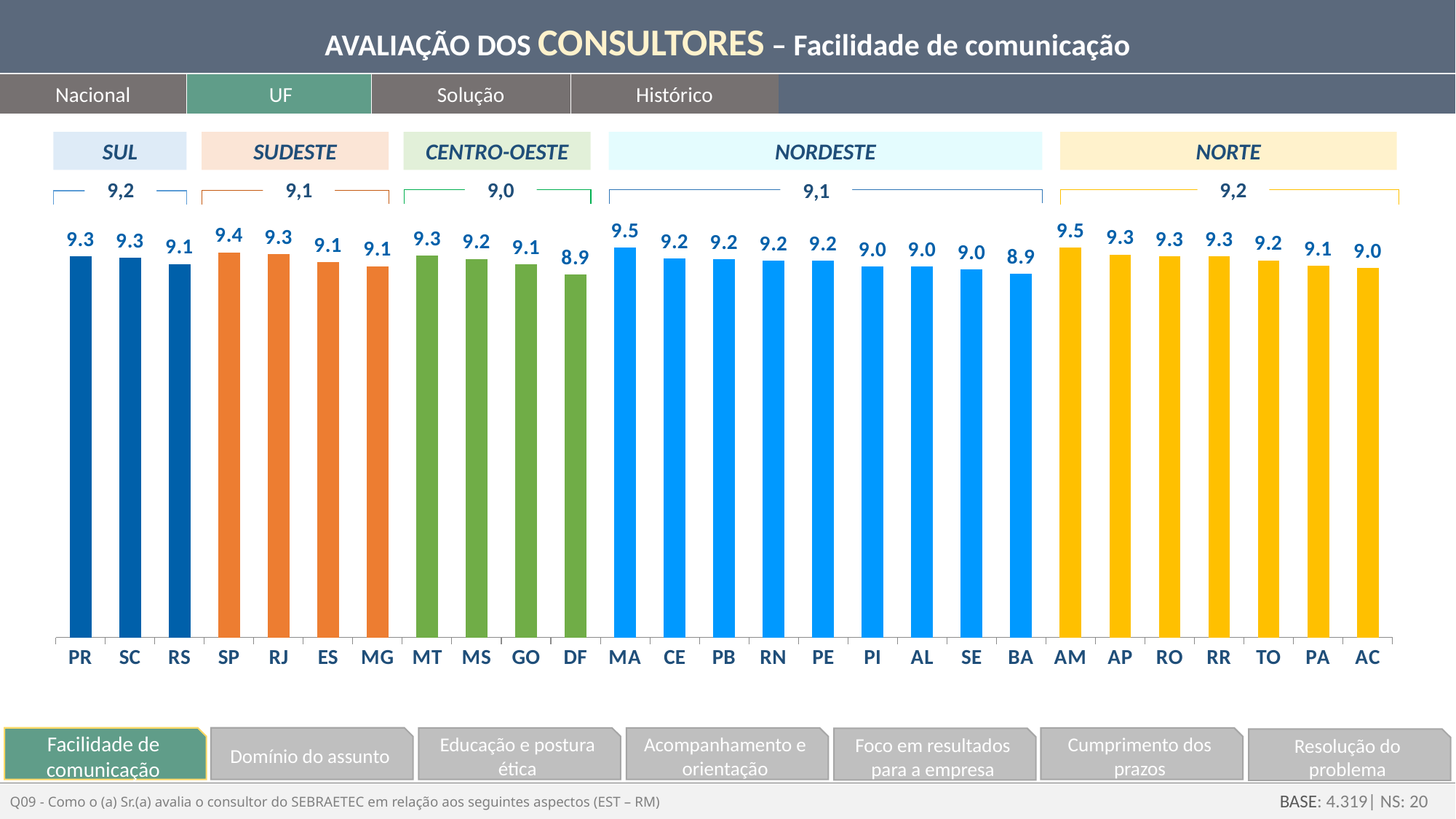
What is the value for AC? 9.0 What kind of chart is shown on the slide? Bar chart What is the difference between the values for MA and BA? 0.6 How many states (bars) are shown in the chart? 27 What is the value for MA? 9.5 What is the value for SP? 9.4 How many regional groups are the bars divided into? 5 What is the regional average shown for NORTE? 9,2 What is the value for DF? 8.9 Which has a larger value, SP or MG? SP Which state in the SUDESTE group has the highest value? SP Which state in the CENTRO-OESTE group has the lowest value? DF